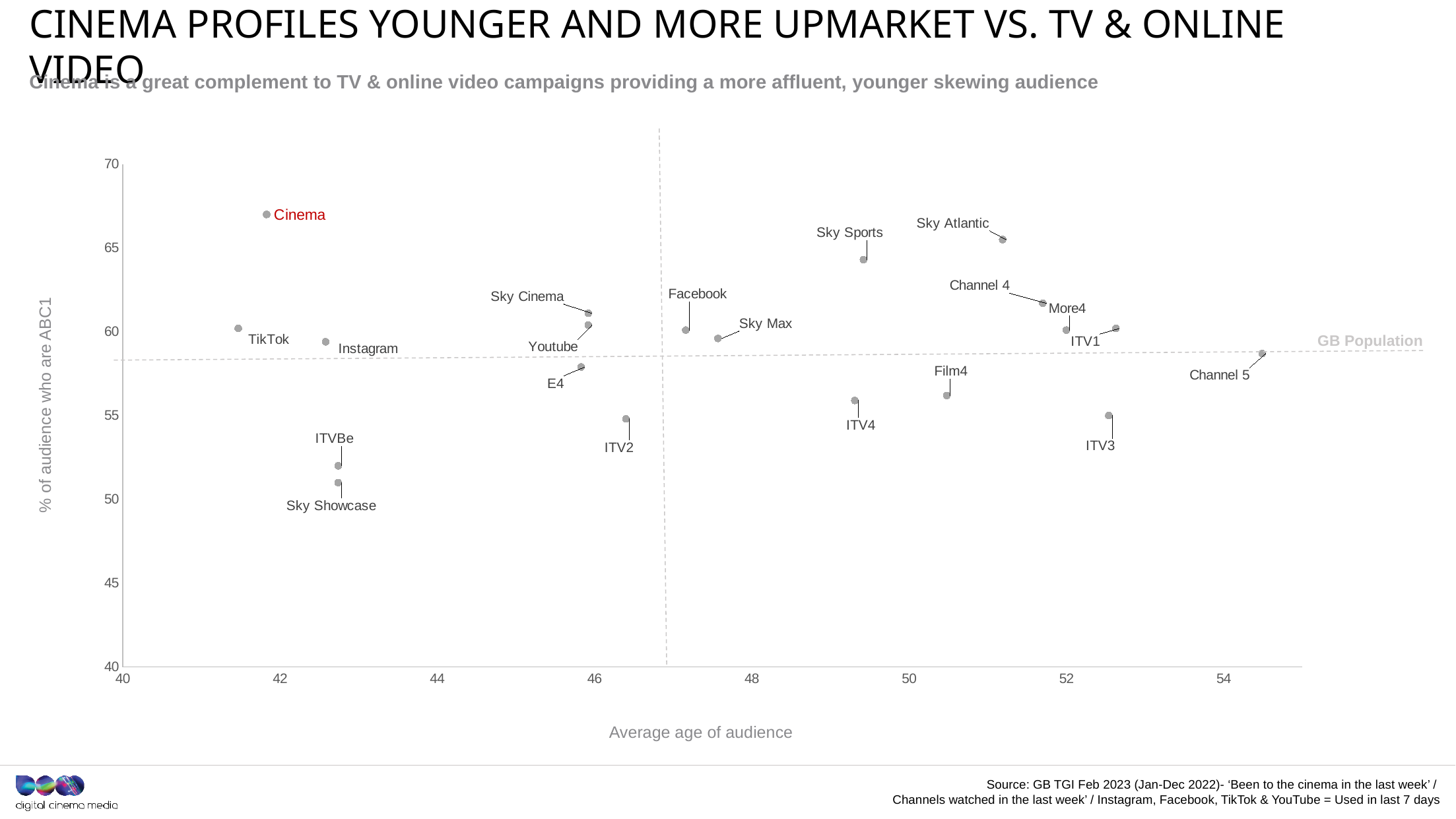
Which point has the highest % of audience who are ABC1? Cinema Is the average age of audience for Channel 5 greater or less than 54? greater Which point has the highest average age of audience? Channel 5 What kind of chart is shown on the slide? Scatter chart Which has a higher average age of audience, TikTok or Channel 5? Channel 5 What does the horizontal dashed line on the chart represent? GB Population Is the % of audience who are ABC1 for Cinema greater or less than 65? greater How many labelled data points are plotted on the chart? 20 Is the % of audience who are ABC1 for Sky Sports greater or less than 60? greater Which point has the lowest % of audience who are ABC1? Sky Showcase Which has a higher % of audience who are ABC1, Cinema or Sky Atlantic? Cinema